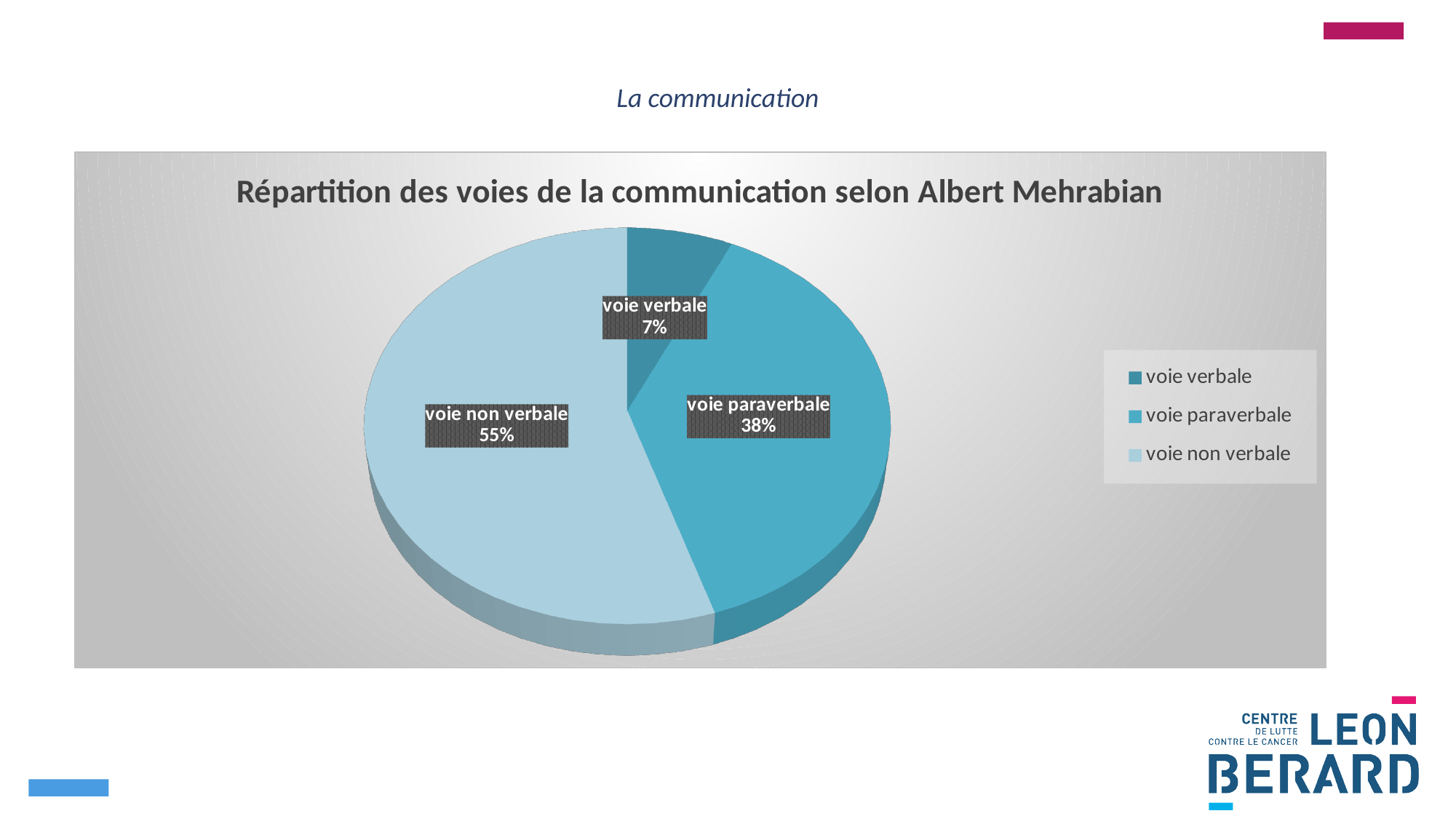
What type of chart is shown on the slide? pie chart Which category has the smallest share of the pie? voie verbale What percentage is shown for voie non verbale? 55% Which is larger, voie paraverbale or voie verbale? voie paraverbale How many slices does the pie chart have? 3 What is the title of the chart? Répartition des voies de la communication selon Albert Mehrabian What is the difference in percentage points between voie paraverbale and voie verbale? 31 Which category has the largest share of the pie? voie non verbale What percentage is shown for voie verbale? 7% How many entries does the legend list? 3 What is the difference in percentage points between voie non verbale and voie paraverbale? 17 What percentage is shown for voie paraverbale? 38%